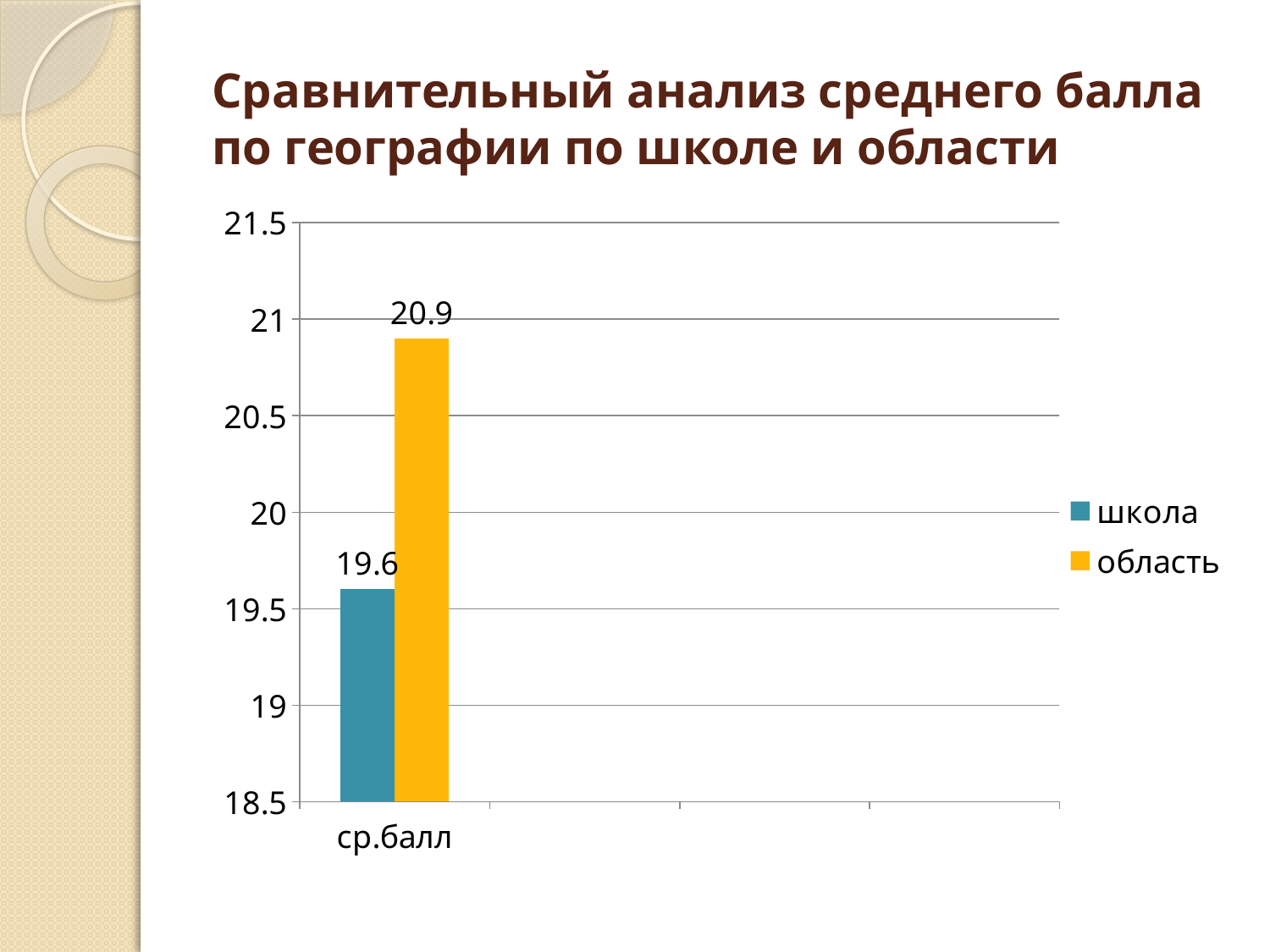
How many categories are shown on the x axis? 1 Which series has the lowest value on the chart? школа What is the label of the category on the x axis? ср.балл What is the value for школа in the ср.балл category? 19.6 What kind of chart is shown on the slide? bar chart What colour is the bar for область? yellow Which series has the higher value: школа or область? область What is the value for область in the ср.балл category? 20.9 How many series does the legend list? 2 Is the value for область greater or less than 20.5? greater What is the difference between the область value and the школа value? 1.3 Is the value for школа greater or less than 20? less